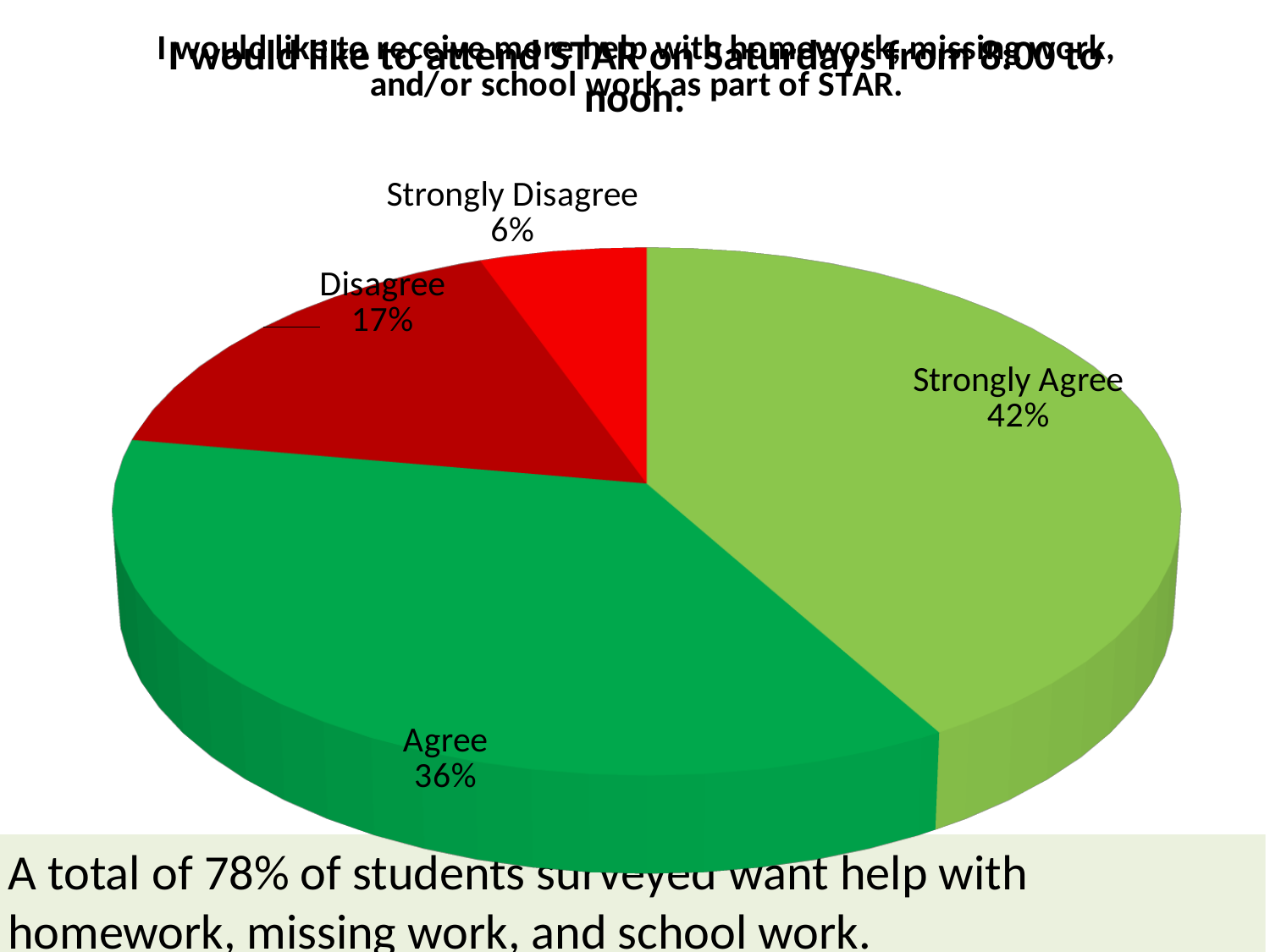
What kind of chart is shown on the slide? pie chart What is the difference in percentage points between Disagree and Strongly Disagree? 11 Which is larger, the Agree slice or the Disagree slice? Agree What percentage of respondents chose Agree? 36% What percentage of respondents chose Strongly Agree? 42% Which response category has the smallest share of the pie? Strongly Disagree What colour is the Strongly Disagree slice? red How many slices does the pie chart have? 4 What percentage of respondents chose Disagree? 17% What percentage of respondents chose Strongly Disagree? 6% What is the difference in percentage points between Strongly Agree and Agree? 6 Which response category has the largest share of the pie? Strongly Agree